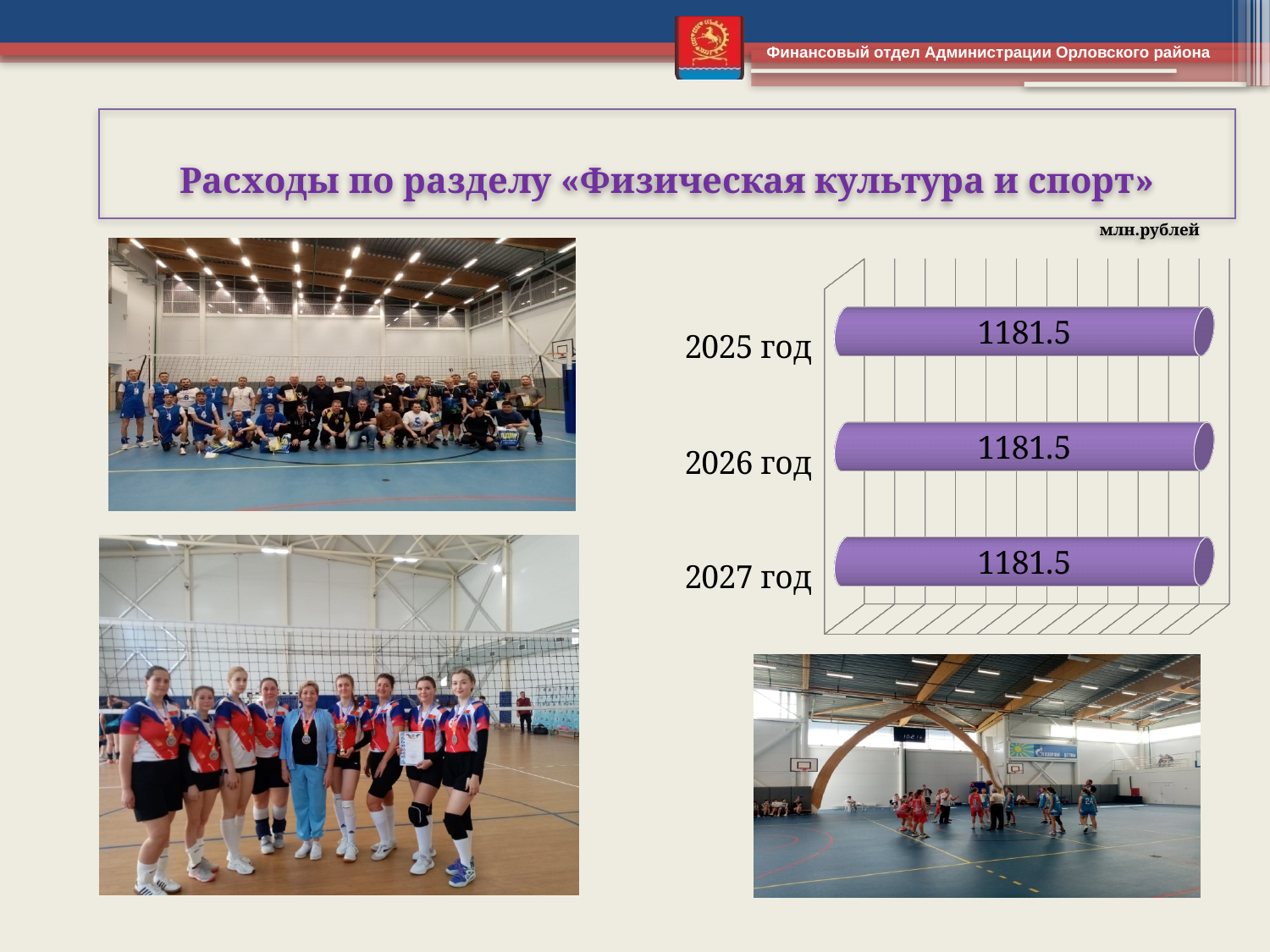
What is the value for 2026 год on the chart? 1181.5 What is the difference between the values for 2025 год and 2027 год? 0 What kind of chart is shown on the slide? Bar chart What unit of measurement is indicated for the chart values? млн.рублей Do the values rise, fall, or stay the same from 2025 год to 2027 год? Stay the same How many categories (years) are shown on the chart? 3 What is the title of the slide containing the chart? Расходы по разделу «Физическая культура и спорт» What is the value for 2027 год on the chart? 1181.5 What is the value for 2025 год on the chart? 1181.5 What is the difference between the values for 2026 год and 2025 год? 0